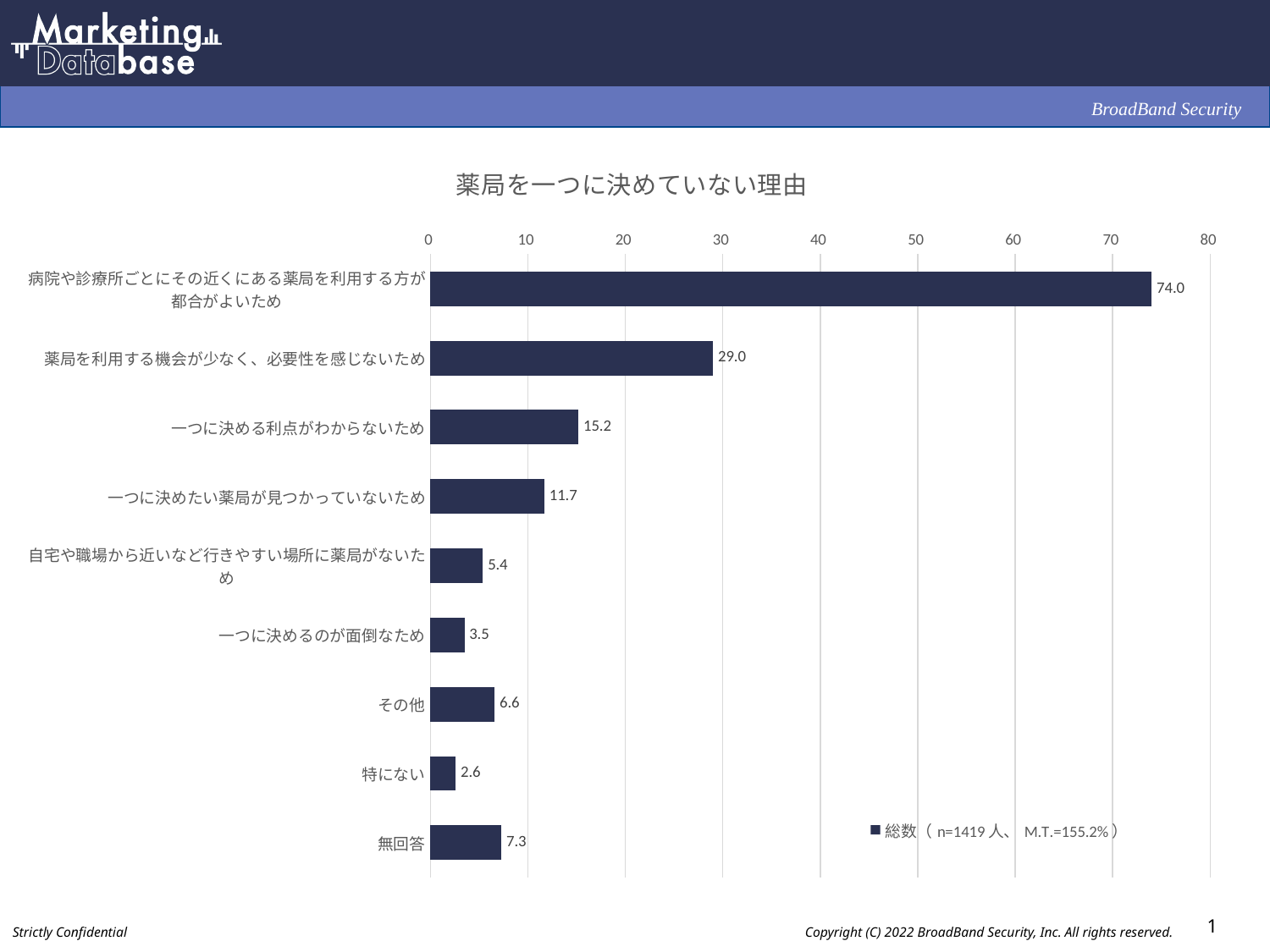
What is the value for 一つに決める利点がわからないため? 15.2 How many categories are shown in the chart? 9 Which category has the lowest value? 特にない What is the difference between the values for 一つに決める利点がわからないため and 一つに決めたい薬局が見つかっていないため? 3.5 What is the value for 一つに決めるのが面倒なため? 3.5 Which category has the highest value? 病院や診療所ごとにその近くにある薬局を利用する方が都合がよいため What is the title of the chart? 薬局を一つに決めていない理由 Which is larger, the value for その他 or the value for 自宅や職場から近いなど行きやすい場所に薬局がないため? その他 Is the value for 薬局を利用する機会が少なく、必要性を感じないため greater or less than 20? greater What kind of chart is shown on the slide? Bar chart What is the value for 無回答? 7.3 What is the value for 薬局を利用する機会が少なく、必要性を感じないため? 29.0